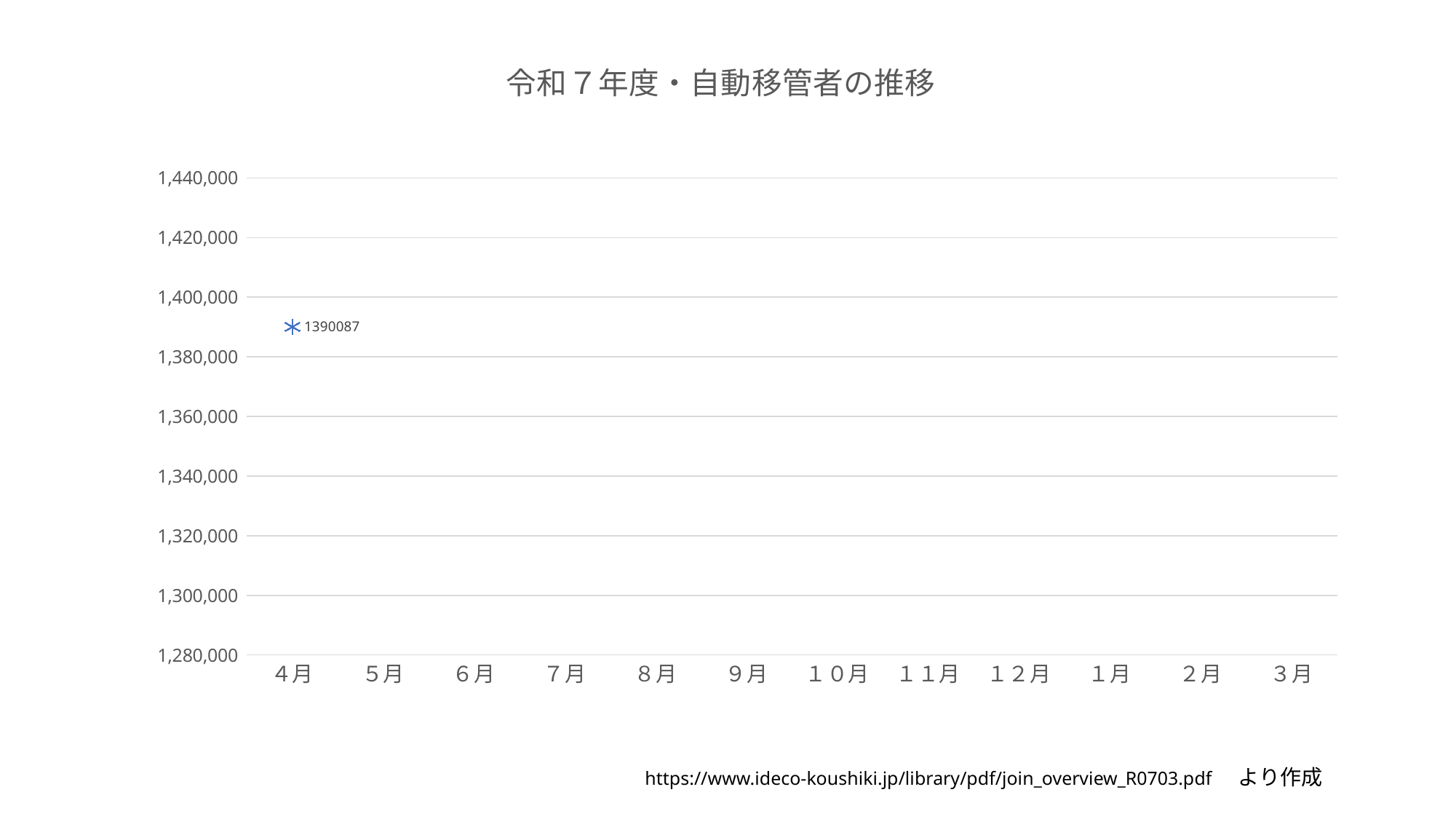
What is the lowest value shown on the y axis? 1,280,000 What is the title of the chart? 令和７年度・自動移管者の推移 Is the value for 4月 greater or less than 1,380,000? greater What is the first month label on the x axis? 4月 What is the highest value shown on the y axis? 1,440,000 Which month is the only one with a plotted value? 4月 Is the value for 4月 greater or less than 1,400,000? less What is the value plotted for 4月? 1390087 How many data points are plotted on the chart? 1 How many month categories are shown on the x axis? 12